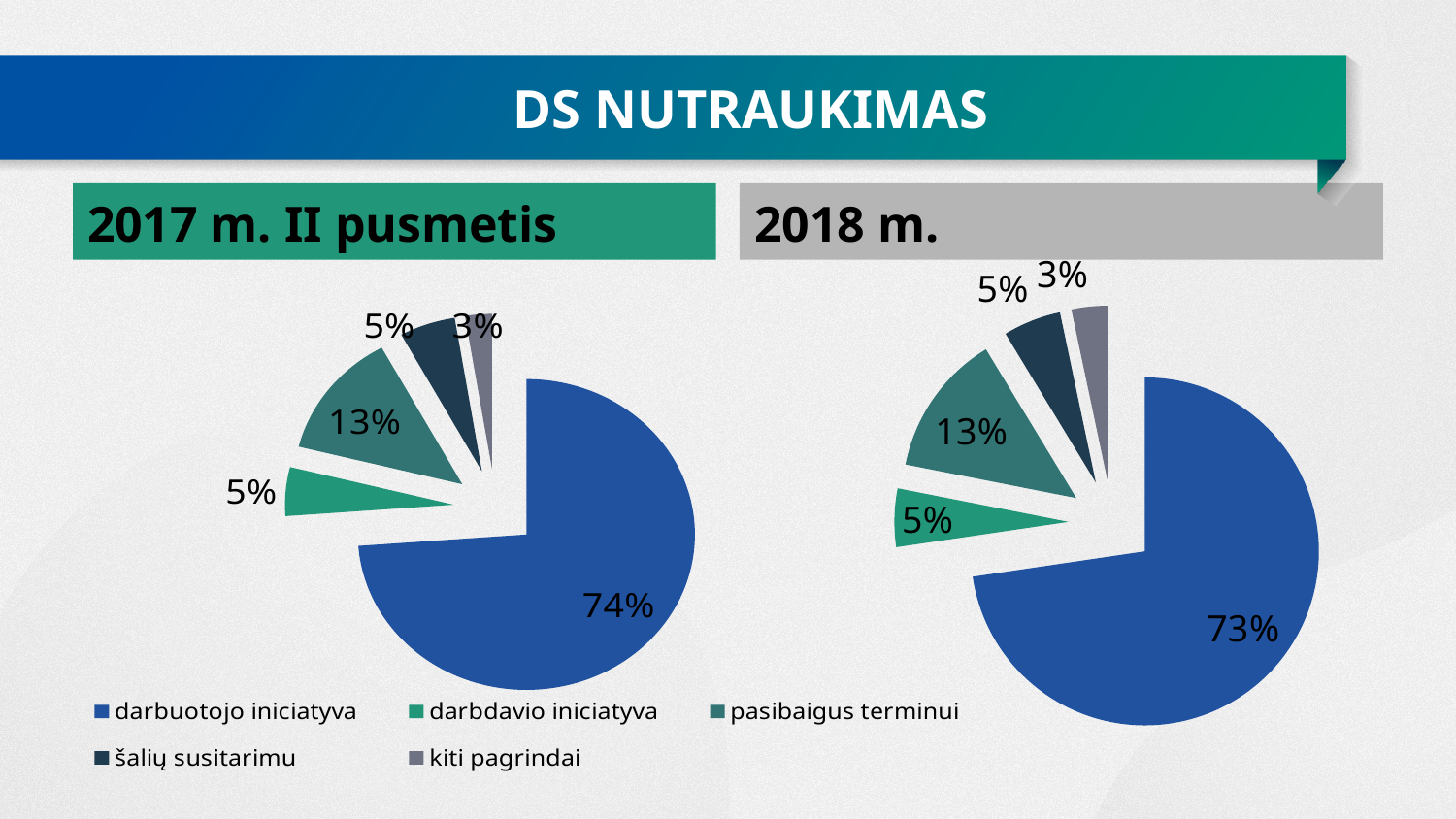
In the 2018 m. pie chart, what share is labelled for kiti pagrindai? 3% In the 2017 m. II pusmetis pie chart, which is larger: the pasibaigus terminui slice or the kiti pagrindai slice? pasibaigus terminui How many entries does the legend list? 5 In the 2017 m. II pusmetis pie chart, what share is labelled for darbuotojo iniciatyva? 74% In the 2017 m. II pusmetis pie chart, which category has the largest slice? darbuotojo iniciatyva What is the difference between the darbuotojo iniciatyva share in the 2017 m. II pusmetis chart and in the 2018 m. chart? 1% What type of chart is used on this slide? Pie chart How many slices does the 2018 m. pie chart have? 5 In the 2018 m. pie chart, what share is labelled for darbdavio iniciatyva? 5% In the 2018 m. pie chart, what share is labelled for darbuotojo iniciatyva? 73% In the 2018 m. pie chart, which category has the smallest slice? kiti pagrindai In the 2017 m. II pusmetis pie chart, what share is labelled for pasibaigus terminui? 13%